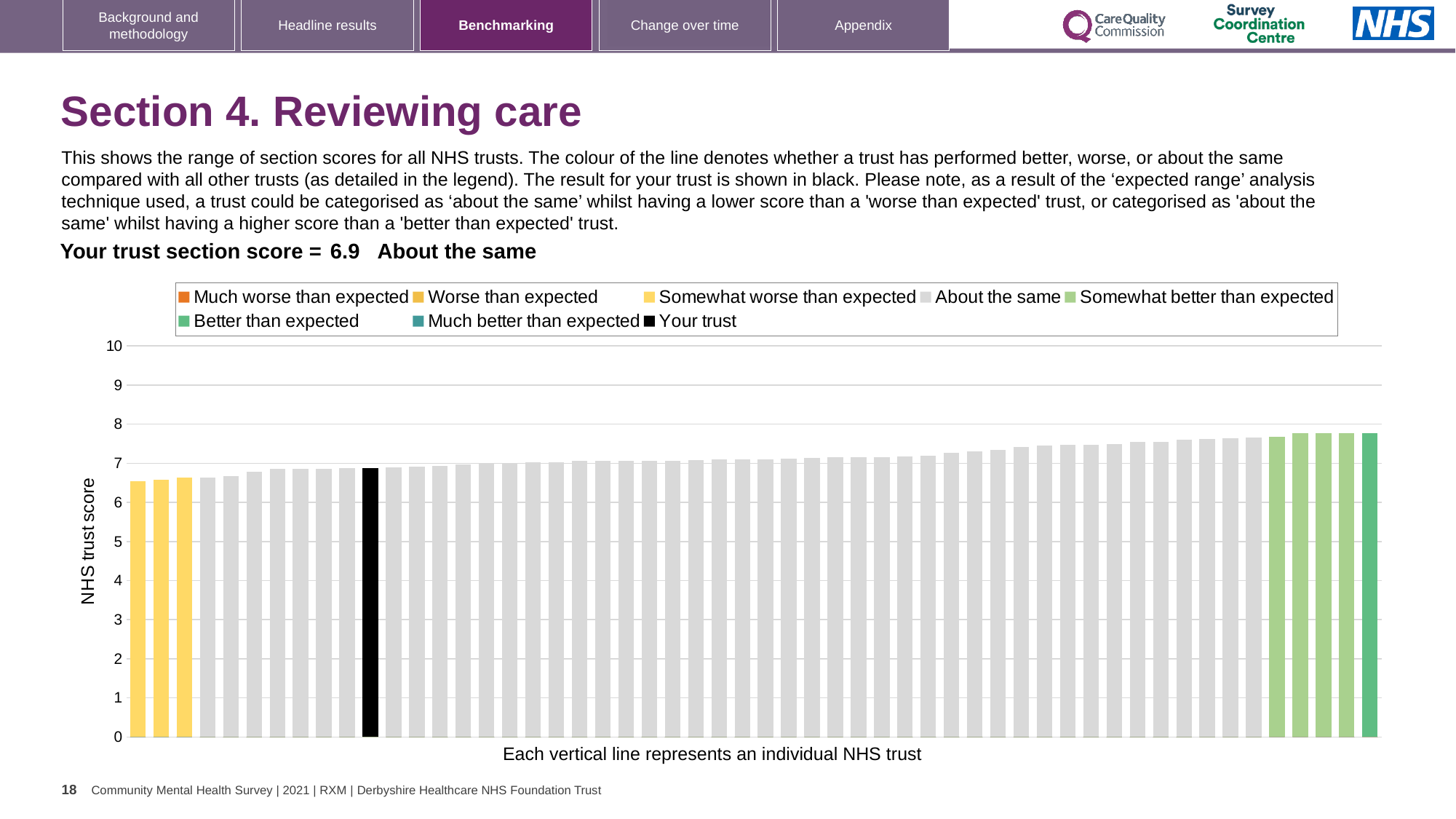
Do the bar values rise or fall from left to right along the x axis? rise How many bars are coloured as 'Somewhat worse than expected' (yellow)? 3 What is the section score for your trust shown on the slide? 6.9 What colour is the bar representing your trust? black What kind of chart is shown on the slide? bar chart Is the rightmost bar larger or smaller than the bar for your trust? larger What is the label on the vertical axis of the chart? NHS trust score Is the value for your trust greater or less than 5? greater Is the value of the tallest bar greater or less than 8? less How many entries does the chart legend list? 8 Which performance category is your trust placed in for this section? About the same Is the value of the shortest bar greater or less than 6? greater